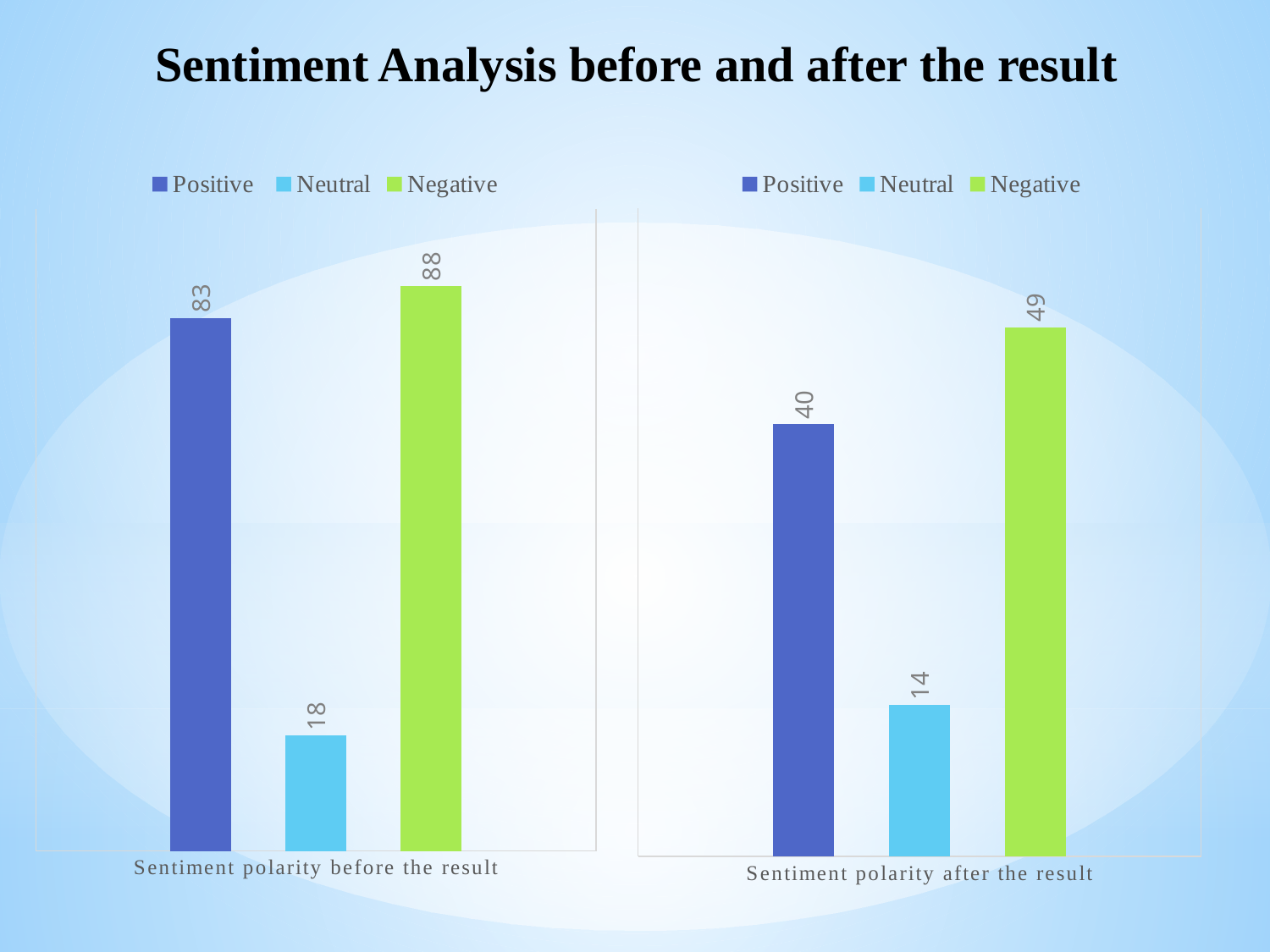
In the left chart (Sentiment polarity before the result), what is the value for Positive? 83 In the left chart (Sentiment polarity before the result), which series has the highest value? Negative In the left chart (Sentiment polarity before the result), what is the value for Neutral? 18 In the left chart (Sentiment polarity before the result), what is the difference between the Negative and Positive values? 5 In the right chart (Sentiment polarity after the result), which is larger, Positive or Negative? Negative In the right chart (Sentiment polarity after the result), what is the difference between the Negative and Positive values? 9 What kind of chart is the right chart (Sentiment polarity after the result)? Bar chart In the right chart (Sentiment polarity after the result), what is the value for Neutral? 14 What colour are the Negative bars in both charts? Green In the right chart (Sentiment polarity after the result), what is the value for Negative? 49 In the right chart (Sentiment polarity after the result), which series has the lowest value? Neutral How many series does the legend of the left chart (Sentiment polarity before the result) list? 3